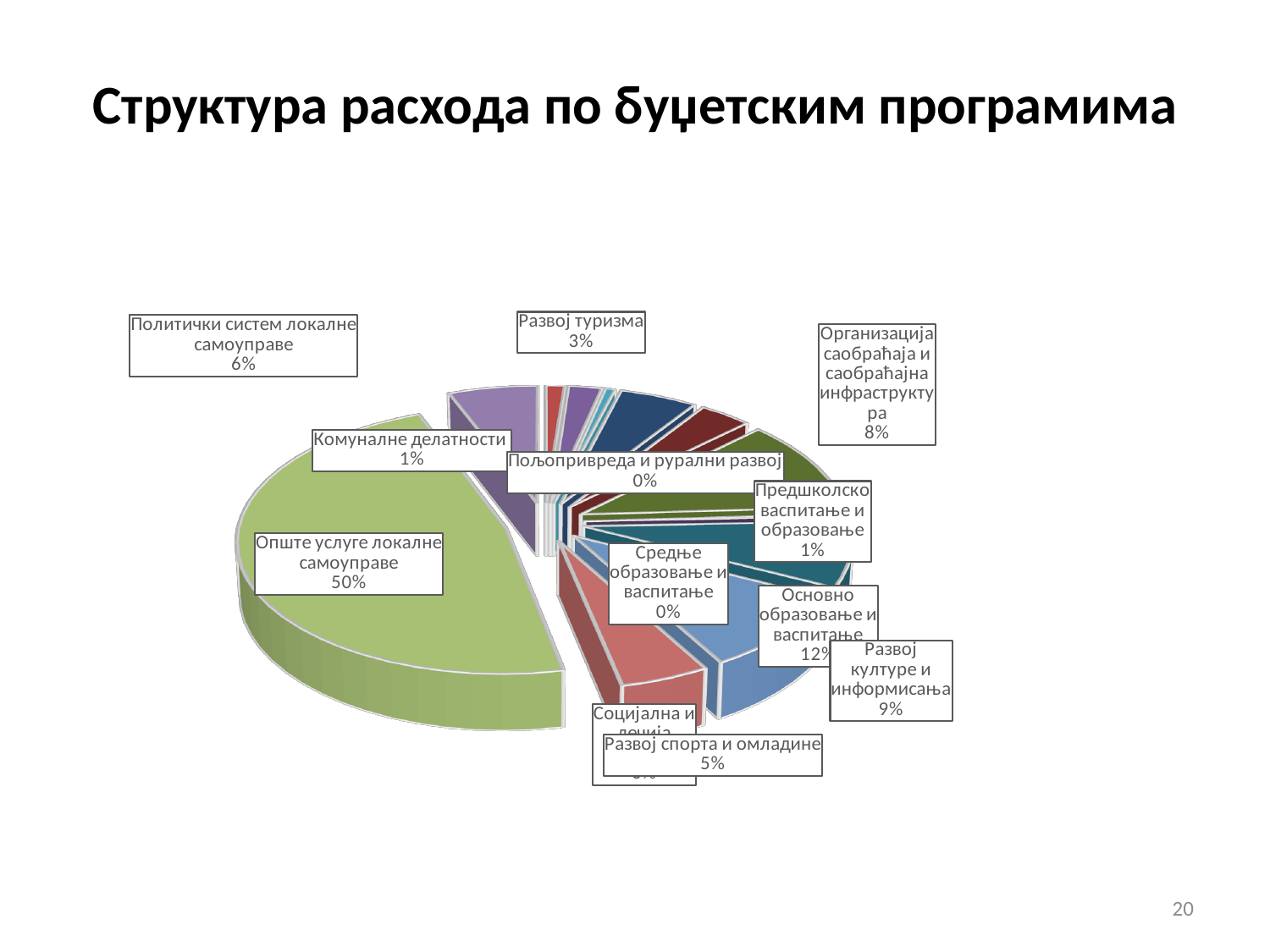
What share is shown for Развој туризма? 3% What share of expenditure goes to Опште услуге локалне самоуправе? 50% What share is shown for Развој спорта и омладине? 5% What share is shown for Развој културе и информисања? 9% Which program has the largest share of expenditure? Опште услуге локалне самоуправе What share is shown for Основно образовање и васпитање? 12% What share is shown for Организација саобраћаја и саобраћајна инфраструктура? 8% What is the difference between the share for Основно образовање и васпитање and the share for Развој културе и информисања? 3% What kind of chart is shown on the slide? pie chart Which is larger: the share for Политички систем локалне самоуправе or the share for Развој туризма? Политички систем локалне самоуправе What is the title of the chart on the slide? Структура расхода по буџетским програмима What share is shown for Комуналне делатности? 1%